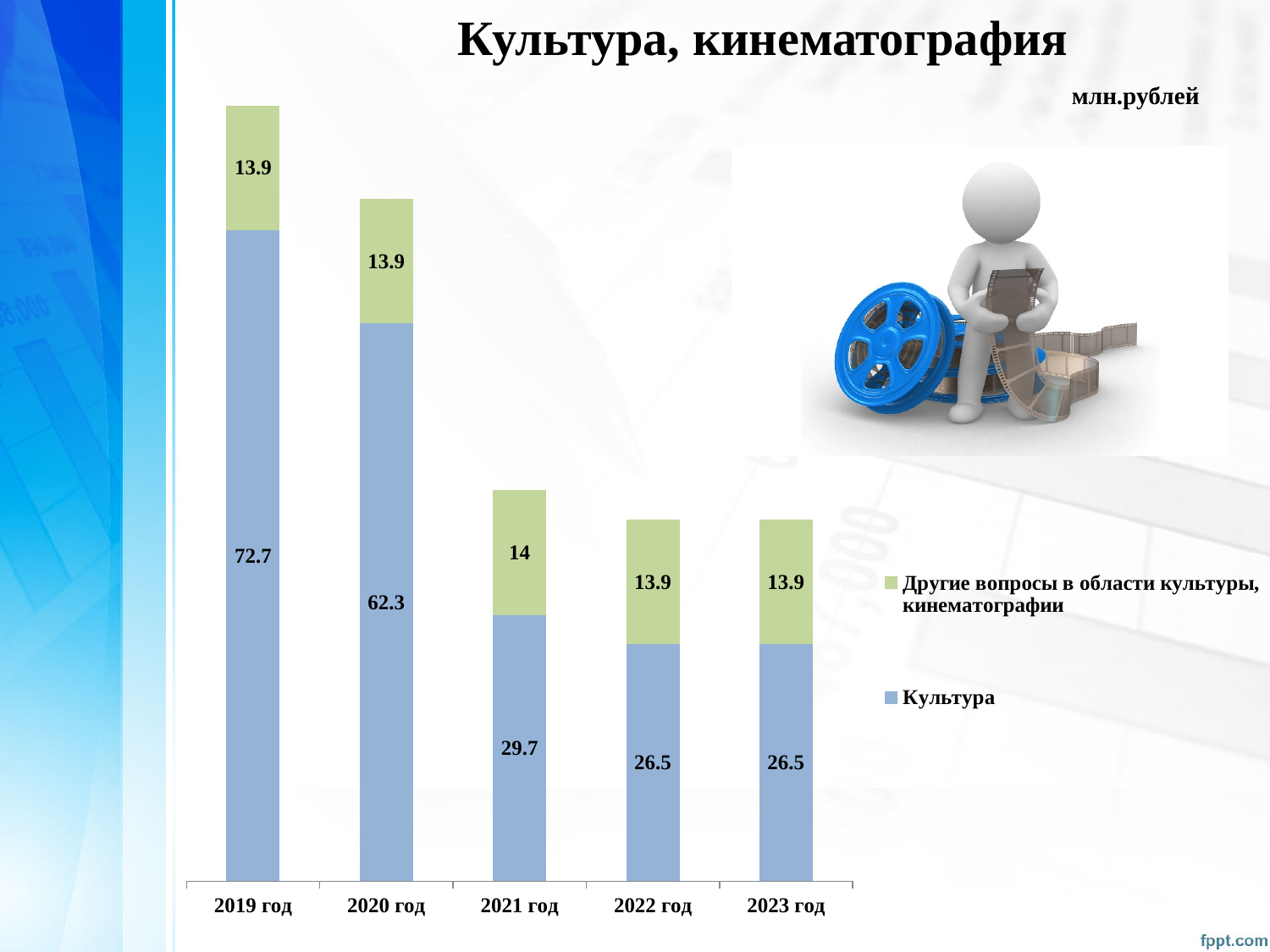
Which year has the highest value for Культура? 2019 год What is the value for Другие вопросы в области культуры, кинематографии in 2021 год? 14 How many series does the legend list? 2 How many years are shown on the x axis? 5 What is the total of the stacked bar for 2019 год? 86.6 Which year has the highest value for Другие вопросы в области культуры, кинематографии? 2021 год What is the value for Культура in 2022 год? 26.5 What kind of chart is shown on the slide? Stacked bar chart What unit is stated for the values on the chart? млн.рублей What is the difference between the Культура values for 2019 год and 2020 год? 10.4 What is the value for Культура in 2019 год? 72.7 Which is larger, the Культура value for 2020 год or for 2021 год? 2020 год